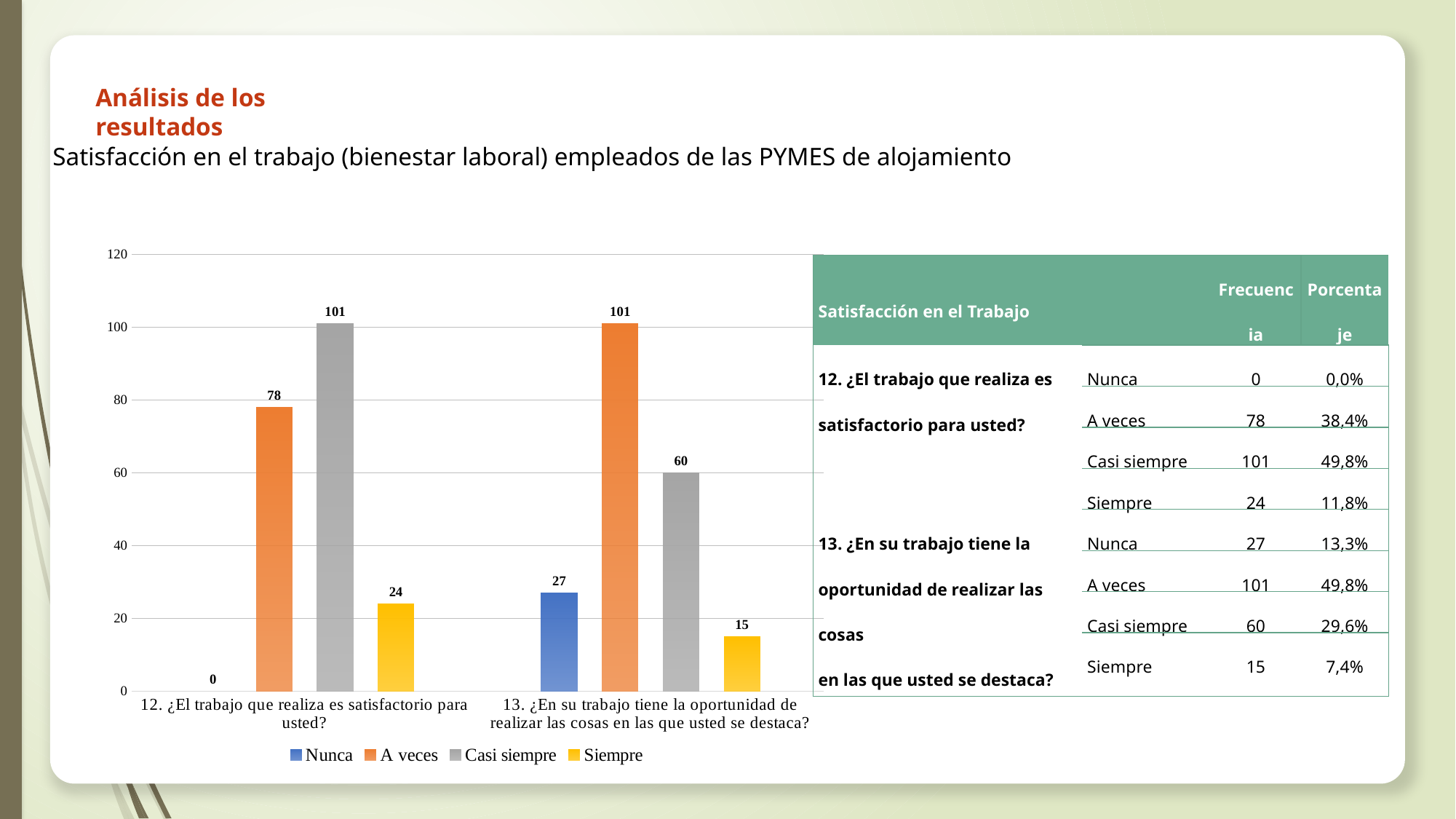
Which response series has the lowest bar for question 12? Nunca What is the value of the 'Siempre' bar for question 12? 24 How many question categories are shown on the x axis of the chart? 2 Which response series has the highest bar for question 13? A veces What colour is the 'Siempre' series in the chart? yellow What is the value of the 'Nunca' bar for question 13 (¿En su trabajo tiene la oportunidad de realizar las cosas en las que usted se destaca?)? 27 What is the value of the 'Casi siempre' bar for question 12 (¿El trabajo que realiza es satisfactorio para usted?)? 101 What type of chart is shown on the slide? bar chart What is the difference between the 'A veces' and 'Casi siempre' bars for question 13? 41 How many series does the chart legend list? 4 Which is larger for question 12: the 'A veces' bar or the 'Casi siempre' bar? Casi siempre Is the 'Casi siempre' bar for question 13 greater or less than 80? less